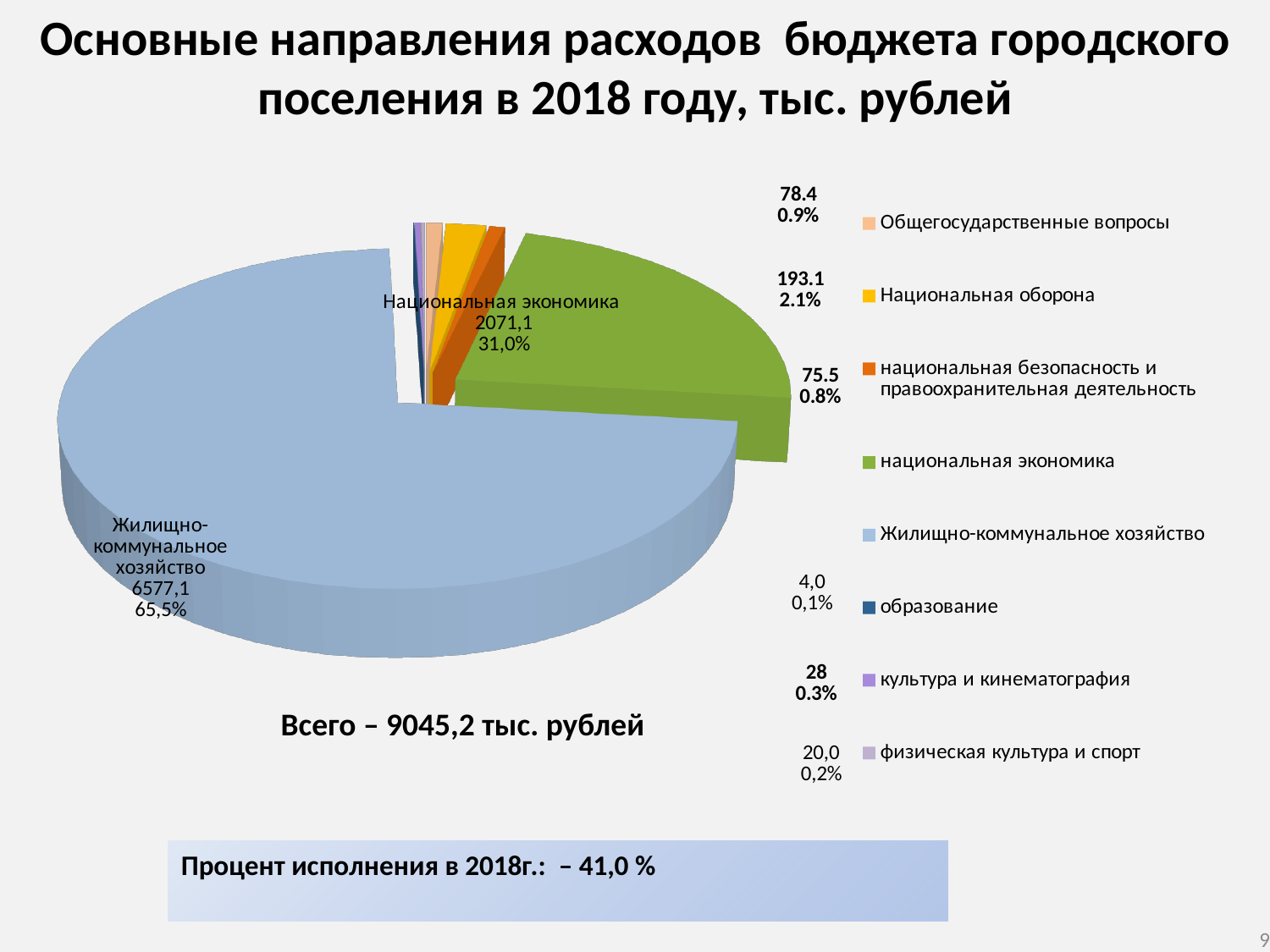
What is the value shown for Жилищно-коммунальное хозяйство? 6577,1 What share of the pie does Национальная экономика account for? 31,0% How many categories does the legend of the pie chart list? 8 What share of the pie does Жилищно-коммунальное хозяйство account for? 65,5% What kind of chart is shown on the slide? pie chart What is the value shown for Национальная экономика? 2071,1 Which category has the smallest share of the pie? образование Which category has the largest slice of the pie? Жилищно-коммунальное хозяйство What total amount is stated below the pie chart? 9045,2 тыс. рублей What colour is the slice for Национальная экономика? green What is the difference between the values for Жилищно-коммунальное хозяйство and Национальная экономика? 4506,0 Which is larger, the share for Национальная оборона or the share for Общегосударственные вопросы? Национальная оборона